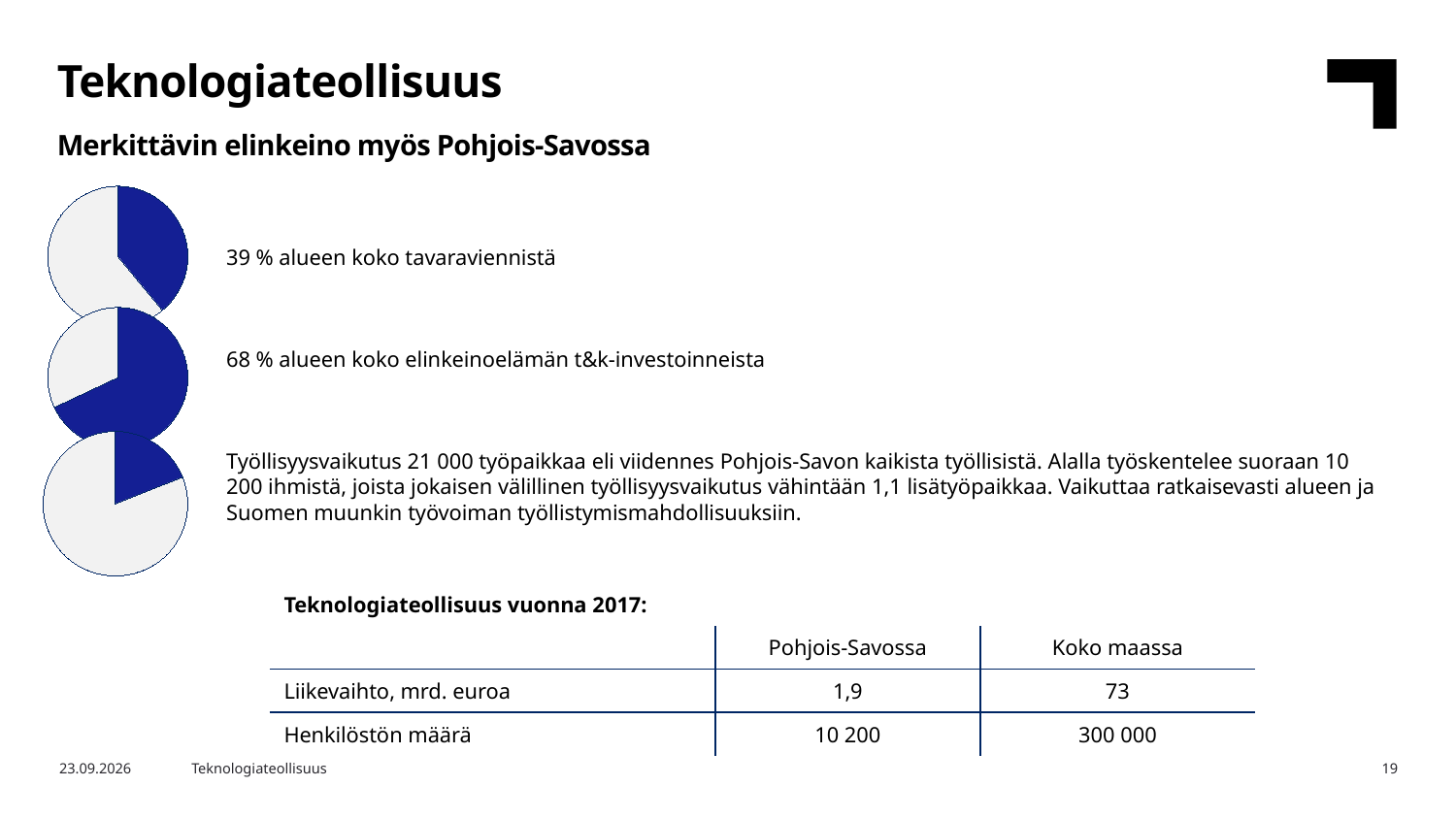
Which of the three pie charts has the smallest blue slice? The bottom one What kind of charts are shown on the left side of the slide? Pie charts Is the blue slice in the middle pie chart larger or smaller than the blue slice in the top pie chart? Larger Is the blue slice in the top pie chart greater or less than 50 % of the pie? less According to the text next to the bottom pie chart, what fraction of all employed people in Pohjois-Savo does the blue slice represent? Viidennes (one fifth) Which of the three pie charts has the largest blue slice? The middle one (68 %) In the top pie chart, what share of the region's total goods exports (tavaravienti) does the blue slice represent? 39 % How many pie charts are on the slide? 3 In the middle pie chart, what share of the region's business R&D investments (t&k-investoinnit) does the blue slice represent? 68 % What colour is used for the highlighted slice in each pie chart? Dark blue What is the difference in percentage points between the blue slices of the middle and top pie charts? 29 percentage points Is the blue slice in the middle pie chart greater or less than 50 % of the pie? greater